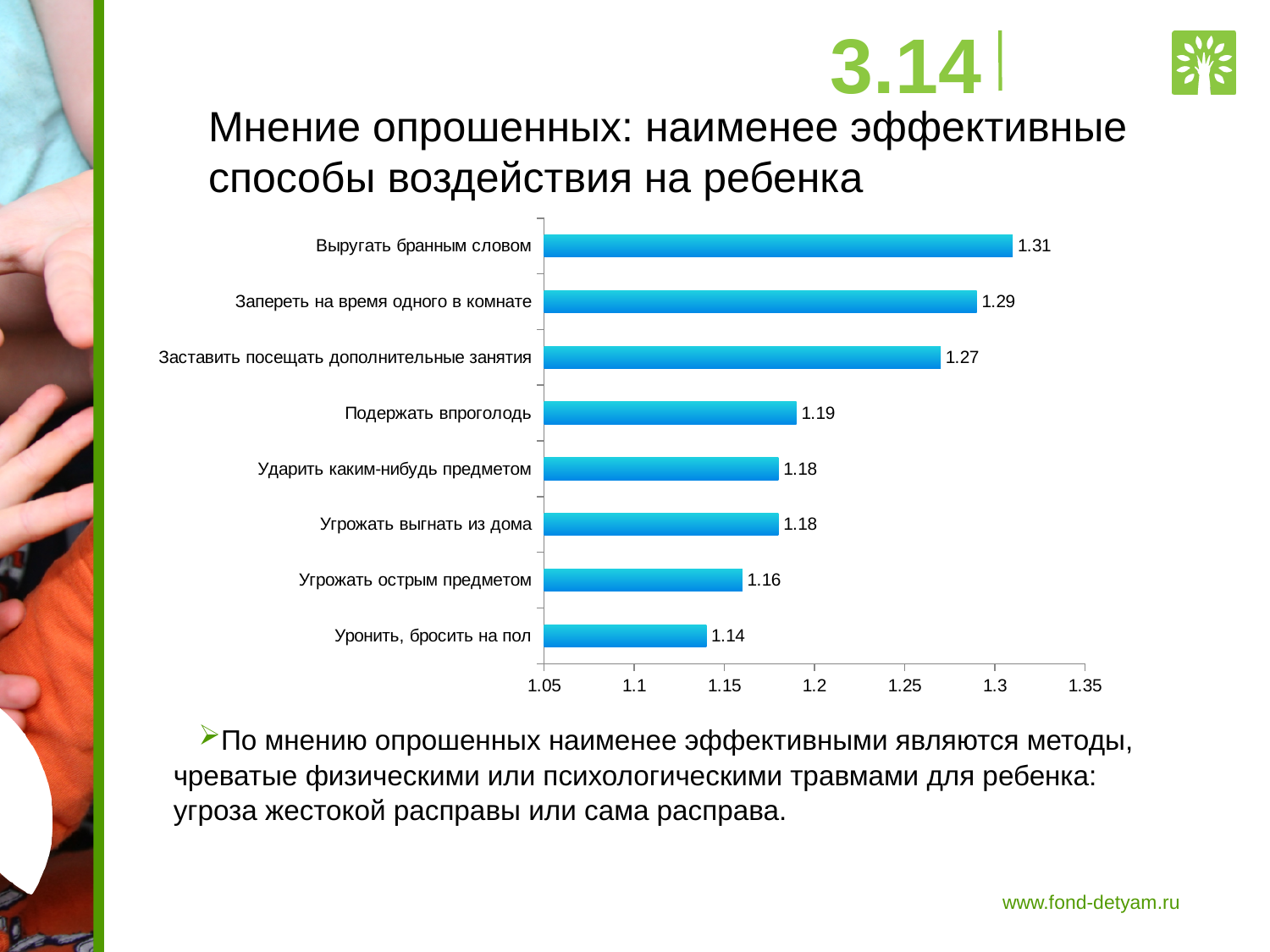
What is the difference between the values for "Выругать бранным словом" and "Уронить, бросить на пол"? 0.17 Which category has the highest value? Выругать бранным словом What kind of chart is shown on the slide? bar chart Which is larger: the value for "Подержать впроголодь" or the value for "Угрожать острым предметом"? Подержать впроголодь How many categories are shown in the chart? 8 What is the value for "Выругать бранным словом"? 1.31 What is the value for "Угрожать выгнать из дома"? 1.18 What is the difference between the values for "Запереть на время одного в комнате" and "Заставить посещать дополнительные занятия"? 0.02 What is the value for "Уронить, бросить на пол"? 1.14 Which category has the lowest value? Уронить, бросить на пол What is the value for "Подержать впроголодь"? 1.19 Is the value for "Заставить посещать дополнительные занятия" greater or less than 1.2? greater